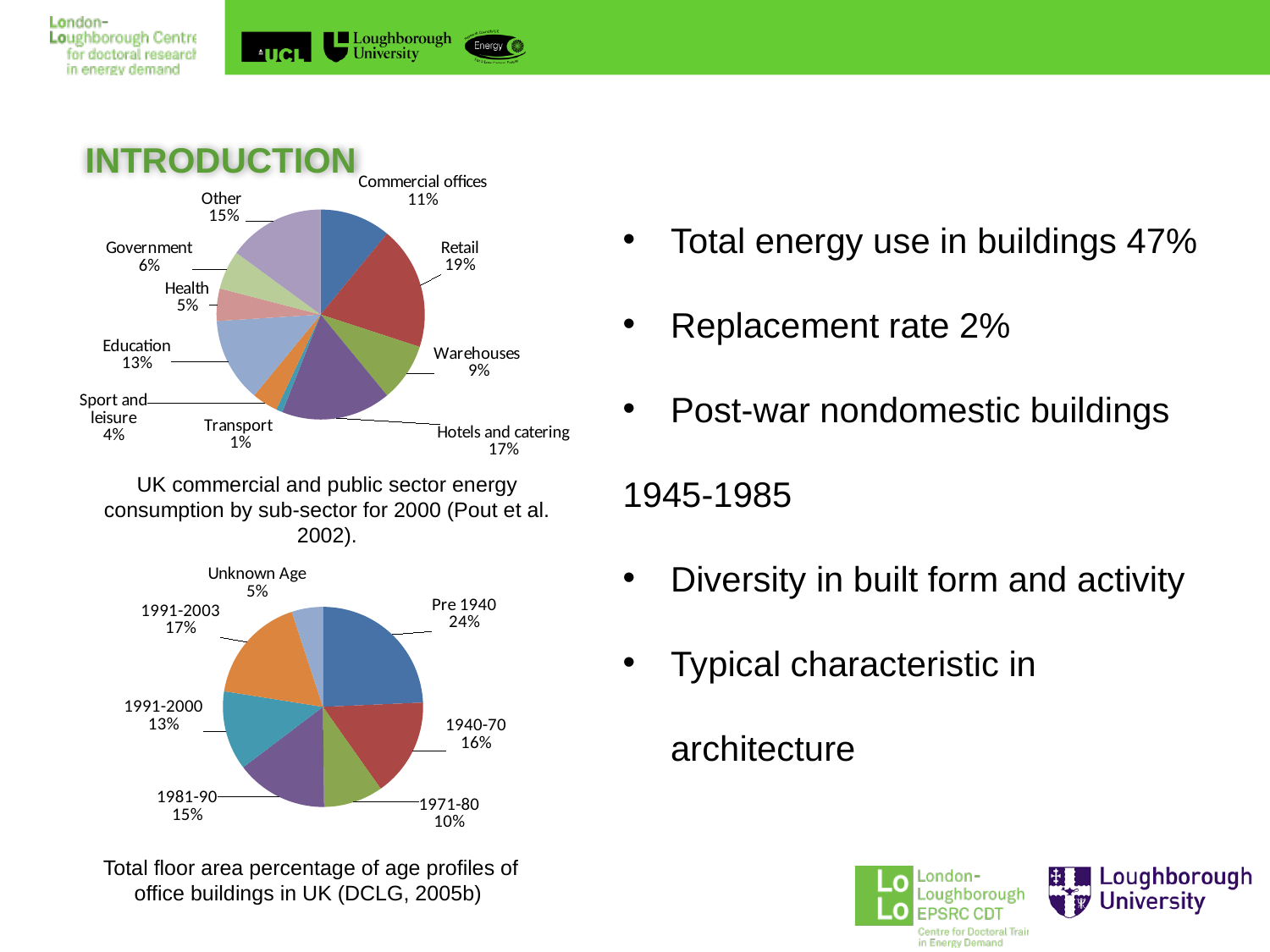
In the top chart (UK commercial and public sector energy consumption by sub-sector for 2000), what percentage is shown for Retail? 19% In the top chart (UK commercial and public sector energy consumption by sub-sector for 2000), what is the difference in percentage points between Hotels and catering and Warehouses? 8 How many age profile categories are shown in the bottom chart (Total floor area percentage of age profiles of office buildings in UK)? 7 In the bottom chart (Total floor area percentage of age profiles of office buildings in UK), what percentage is shown for 1981-90? 15% How many sub-sectors are shown in the top chart (UK commercial and public sector energy consumption by sub-sector for 2000)? 10 In the top chart (UK commercial and public sector energy consumption by sub-sector for 2000), which sub-sector has the largest share? Retail In the bottom chart (Total floor area percentage of age profiles of office buildings in UK), what is the difference in percentage points between Pre 1940 and 1971-80? 14 What type of chart is the top chart (UK commercial and public sector energy consumption by sub-sector for 2000)? Pie chart In the top chart (UK commercial and public sector energy consumption by sub-sector for 2000), which sub-sector has the smallest share? Transport In the bottom chart (Total floor area percentage of age profiles of office buildings in UK), which age profile has the smallest share? Unknown Age In the top chart (UK commercial and public sector energy consumption by sub-sector for 2000), which is larger, Education or Commercial offices? Education In the bottom chart (Total floor area percentage of age profiles of office buildings in UK), which age profile has the largest share? Pre 1940